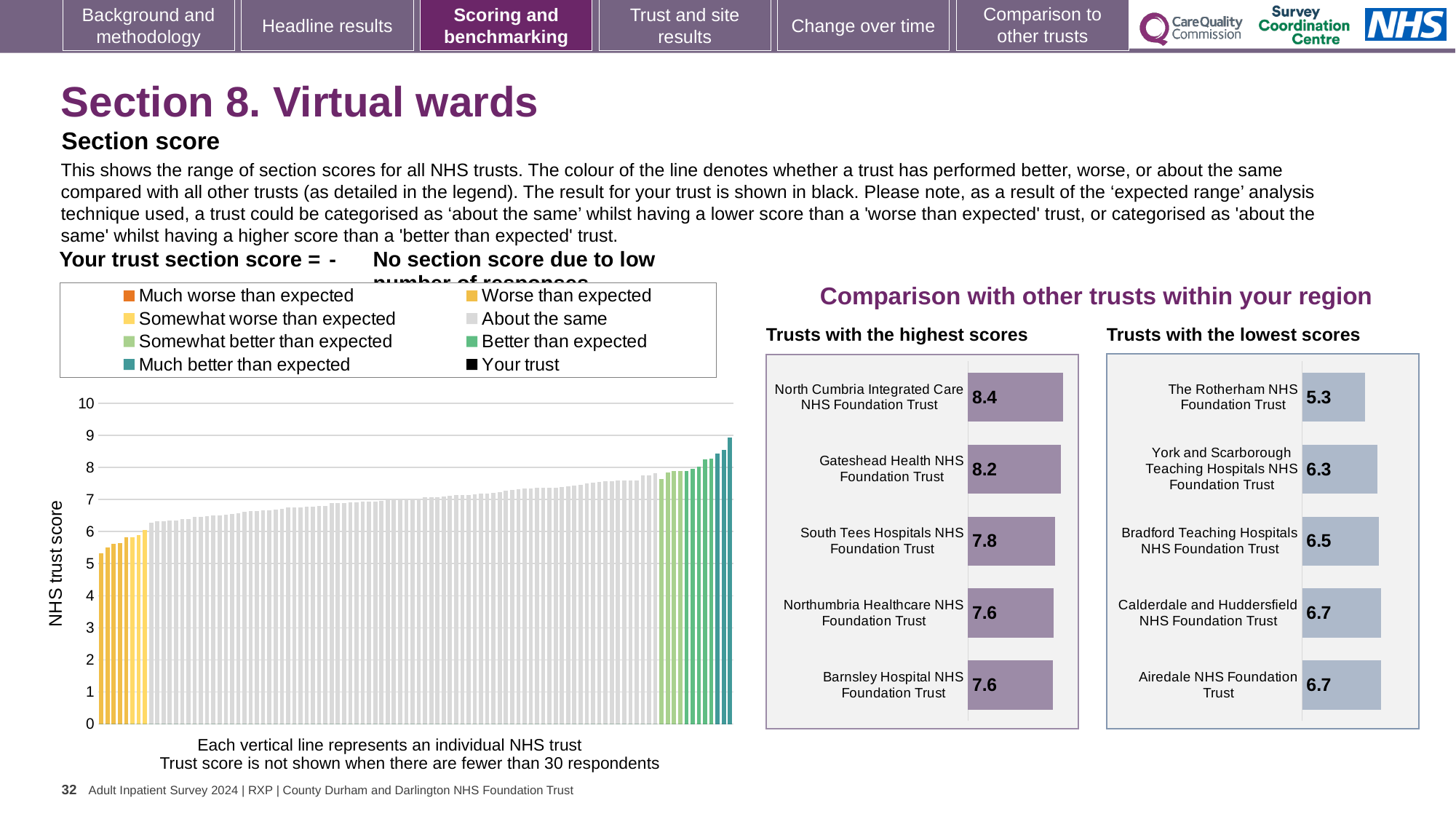
In the 'Trusts with the lowest scores' chart, what is the score for The Rotherham NHS Foundation Trust? 5.3 How many trusts are listed in the 'Trusts with the lowest scores' chart? 5 In the 'Trusts with the lowest scores' chart, what is the difference between the scores of Bradford Teaching Hospitals NHS Foundation Trust and The Rotherham NHS Foundation Trust? 1.2 In the large chart on the left showing the range of section scores, do the values rise or fall from left to right? rise How many entries does the legend of the large chart on the left list? 8 In the 'Trusts with the highest scores' chart, which trust has the highest score? North Cumbria Integrated Care NHS Foundation Trust In the 'Trusts with the highest scores' chart, what is the score for South Tees Hospitals NHS Foundation Trust? 7.8 In the 'Trusts with the lowest scores' chart, which trust has the lowest score? The Rotherham NHS Foundation Trust In the 'Trusts with the highest scores' chart, what is the difference between the scores of North Cumbria Integrated Care NHS Foundation Trust and Gateshead Health NHS Foundation Trust? 0.2 In the 'Trusts with the lowest scores' chart, which has the higher score: York and Scarborough Teaching Hospitals NHS Foundation Trust or Calderdale and Huddersfield NHS Foundation Trust? Calderdale and Huddersfield NHS Foundation Trust In the 'Trusts with the highest scores' chart, what is the score for North Cumbria Integrated Care NHS Foundation Trust? 8.4 In the large chart on the left showing the range of section scores, is the value of the tallest bar greater or less than 8? greater